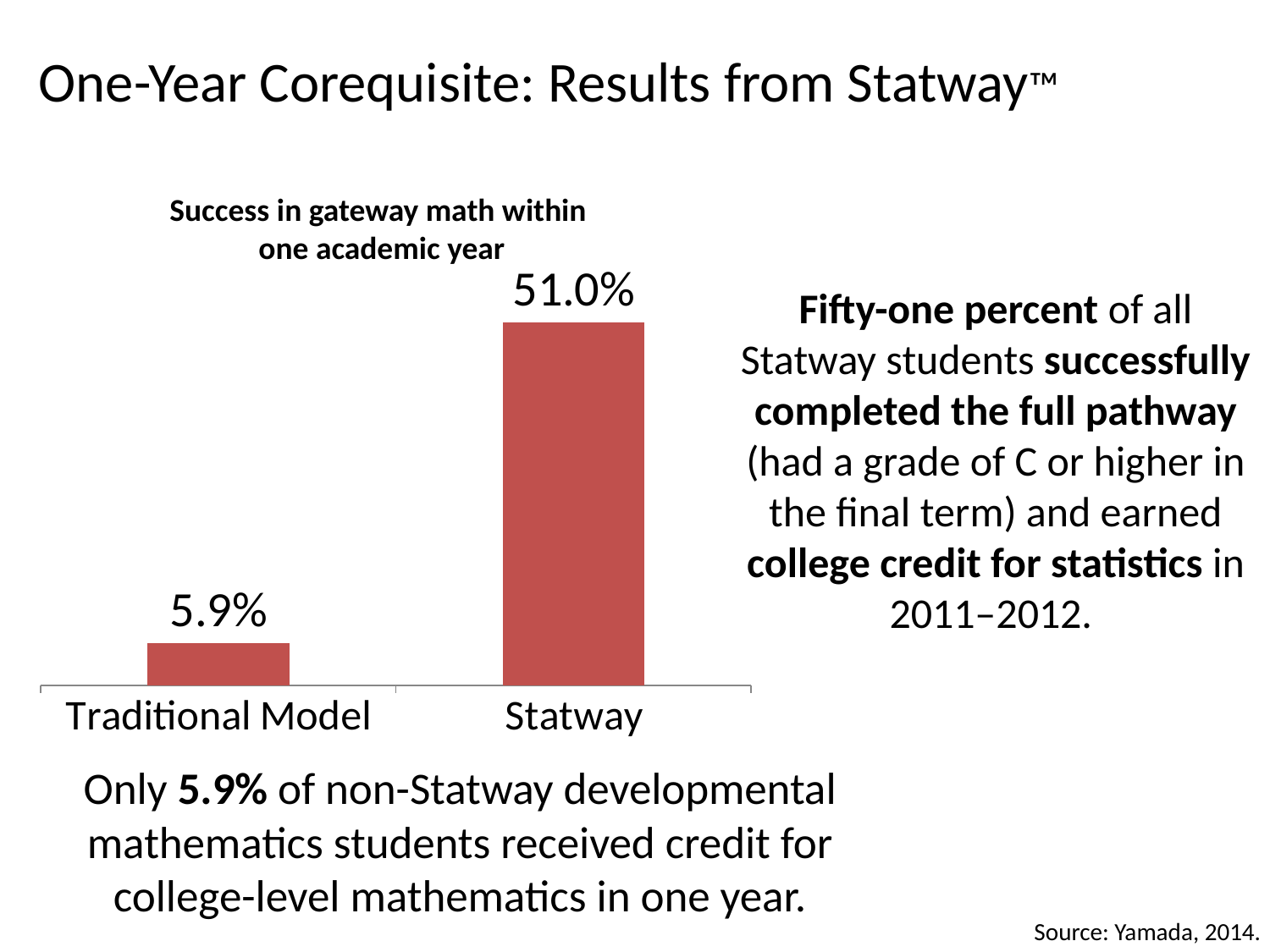
What is the value for Statway? 51.0% Which is larger, the value for Statway or the value for Traditional Model? Statway What colour are the bars in the chart? Red Which category has the highest value? Statway What kind of chart is shown on the slide? Bar chart Which category has the lowest value? Traditional Model What is the title of the chart? Success in gateway math within one academic year What is the value for Traditional Model? 5.9% How many categories are shown in the chart? 2 What is the difference between the values for Statway and Traditional Model? 45.1%